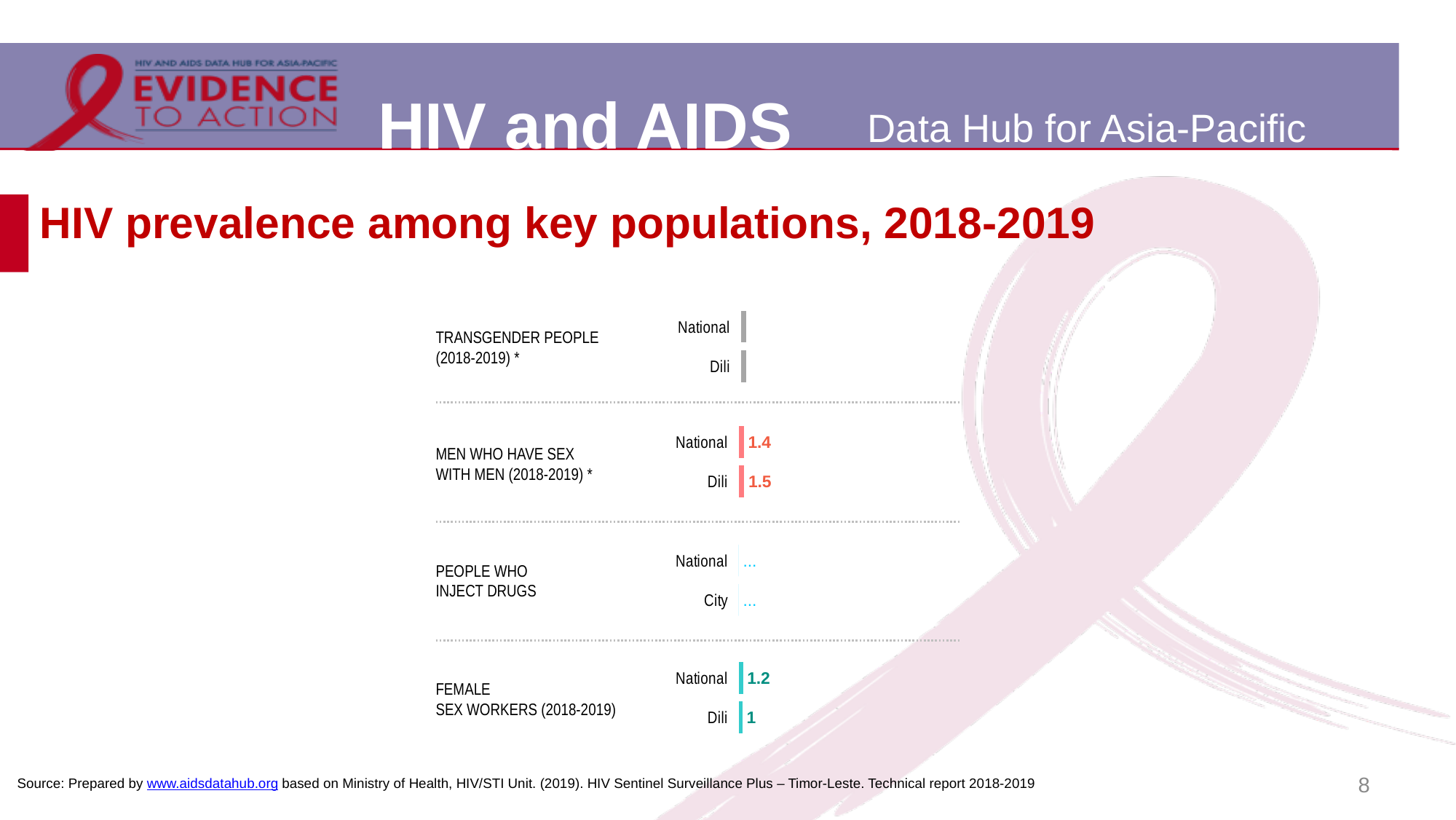
What is the difference between the Dili and national HIV prevalence values for men who have sex with men? 0.1 What is the title of the chart on the slide? HIV prevalence among key populations, 2018-2019 What is the HIV prevalence among men who have sex with men at the national level? 1.4 What kind of chart is shown on the slide? Bar chart What is the difference between the national and Dili HIV prevalence values for female sex workers? 0.2 Which is larger for men who have sex with men: the national value or the Dili value? Dili What is the HIV prevalence among men who have sex with men in Dili? 1.5 What is the HIV prevalence among female sex workers in Dili? 1 What is the HIV prevalence among female sex workers at the national level? 1.2 Which is larger for female sex workers: the national value or the Dili value? National What value is shown for people who inject drugs at the national level? … How many key population groups are shown in the chart? 4